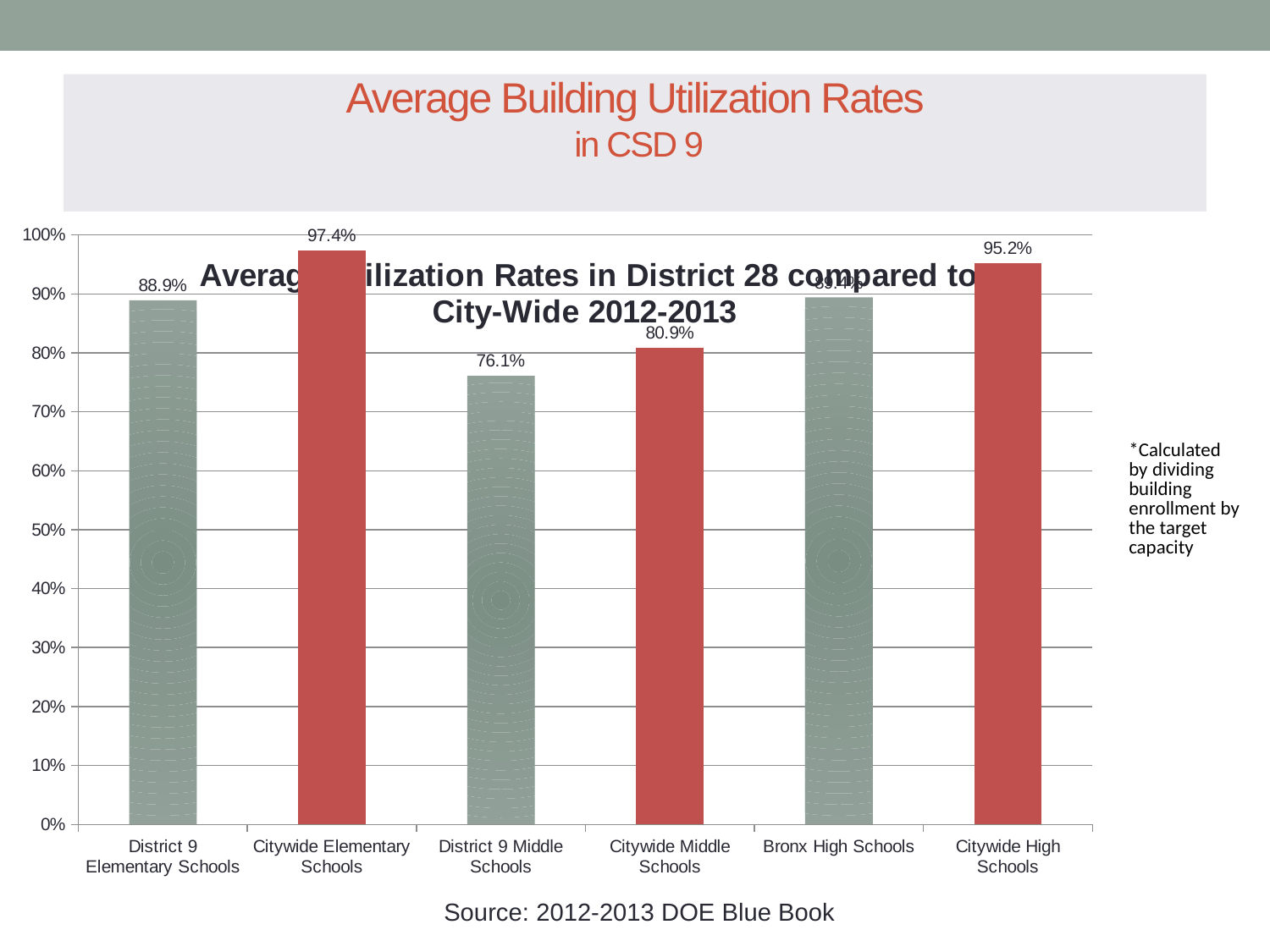
How many categories are shown on the x axis of the chart? 6 What is the average building utilization rate for Citywide High Schools? 95.2% What is the average building utilization rate for Citywide Elementary Schools? 97.4% What kind of chart is shown on the slide? Bar chart What is the average building utilization rate for Citywide Middle Schools? 80.9% How many percentage points higher is the Citywide Elementary Schools rate than the District 9 Elementary Schools rate? 8.5 percentage points Which category has the highest utilization rate? Citywide Elementary Schools What is the average building utilization rate for District 9 Elementary Schools? 88.9% Which is larger, the utilization rate for District 9 Middle Schools or for Citywide Middle Schools? Citywide Middle Schools Is the value for Bronx High Schools greater or less than 80%? greater Which category has the lowest utilization rate? District 9 Middle Schools What is the average building utilization rate for District 9 Middle Schools? 76.1%